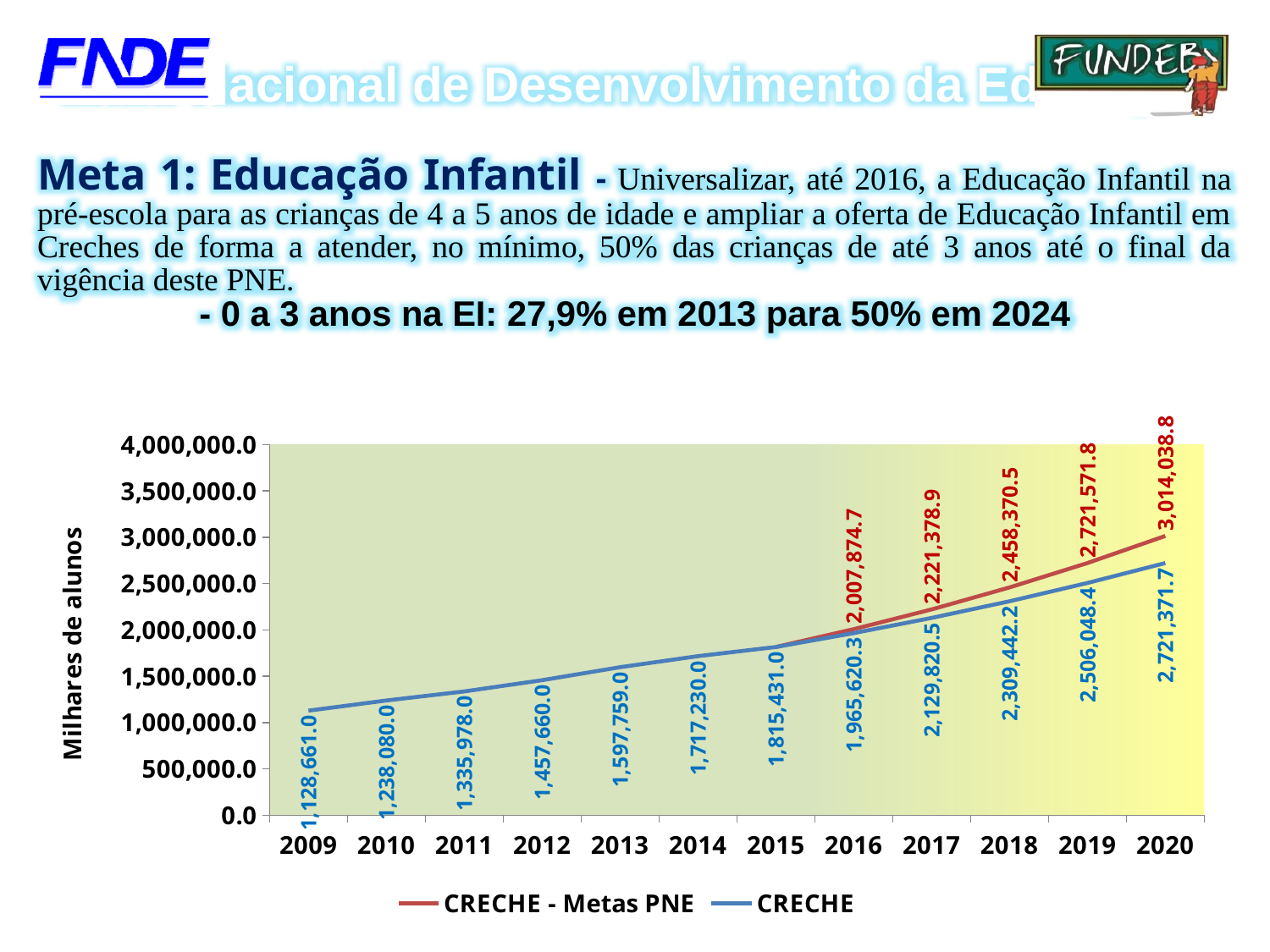
What is the CRECHE value for 2015? 1,815,431.0 How many series does the legend list? 2 Which series has the larger value in 2019, CRECHE - Metas PNE or CRECHE? CRECHE - Metas PNE What kind of chart is shown? Line chart What is the difference between the CRECHE - Metas PNE value and the CRECHE value in 2020? 292,667.1 Does the CRECHE series rise or fall from 2009 to 2020? Rise In which year is the CRECHE series highest? 2020 What is the CRECHE - Metas PNE value for 2020? 3,014,038.8 What is the CRECHE - Metas PNE value for 2018? 2,458,370.5 In which year is the CRECHE series lowest? 2009 How many years are shown on the x axis? 12 What is the CRECHE value for 2009? 1,128,661.0